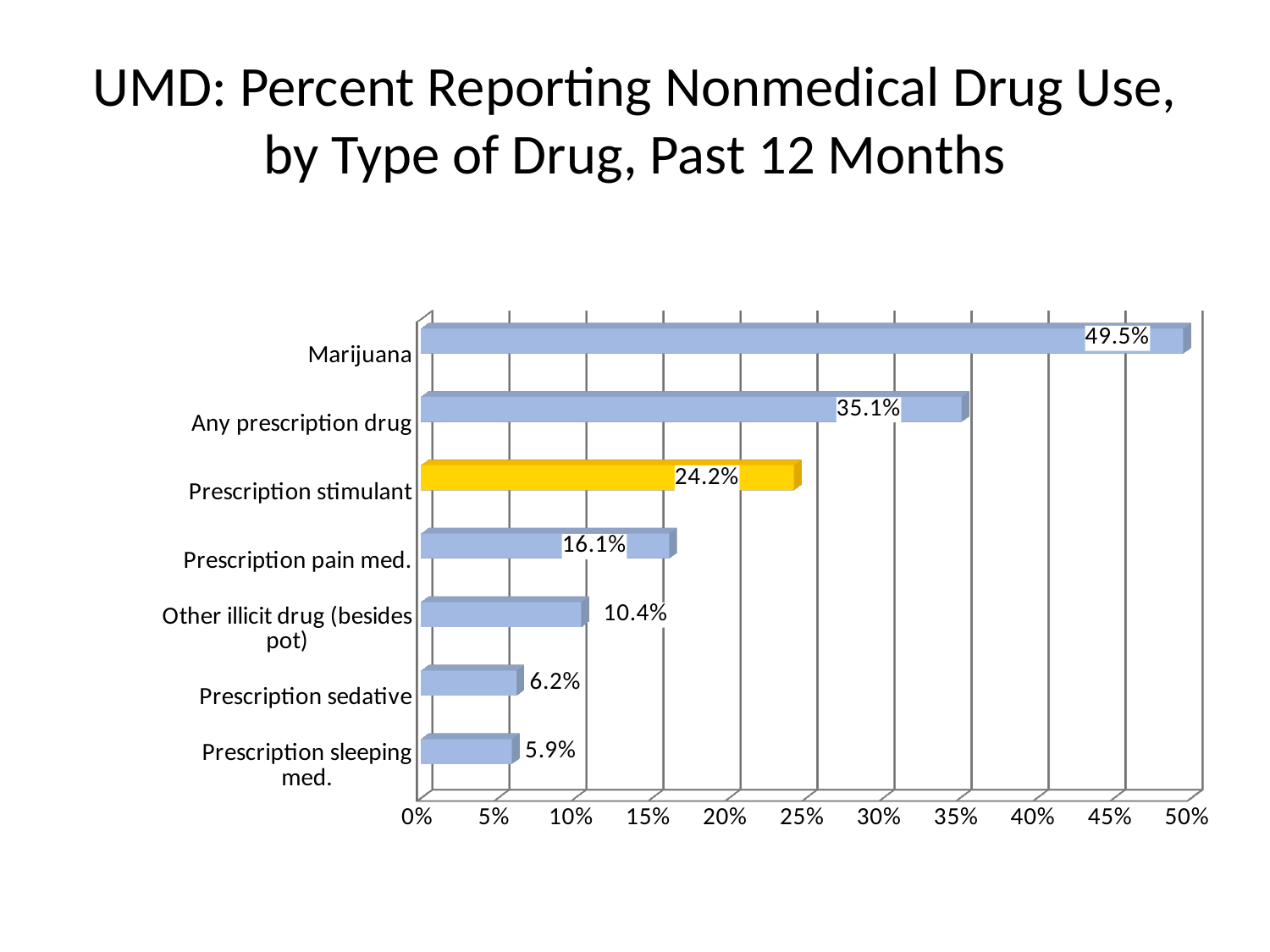
What is the value shown for Prescription stimulant? 24.2% What kind of chart is shown on the slide? Bar chart What percent reported nonmedical use of marijuana in the past 12 months? 49.5% How many types of drug are shown in the chart? 7 Is the value for Any prescription drug greater or less than 30%? greater What is the value for Other illicit drug (besides pot)? 10.4% Which type of drug has the lowest percent reporting nonmedical use? Prescription sleeping med. What is the difference between the values for Any prescription drug and Prescription stimulant? 10.9% Which is larger, the value for Prescription pain med. or the value for Prescription sedative? Prescription pain med. Which bar is highlighted in a different colour (yellow) from the others? Prescription stimulant What percent reported nonmedical use of prescription sleeping med.? 5.9% Which type of drug has the highest percent reporting nonmedical use? Marijuana